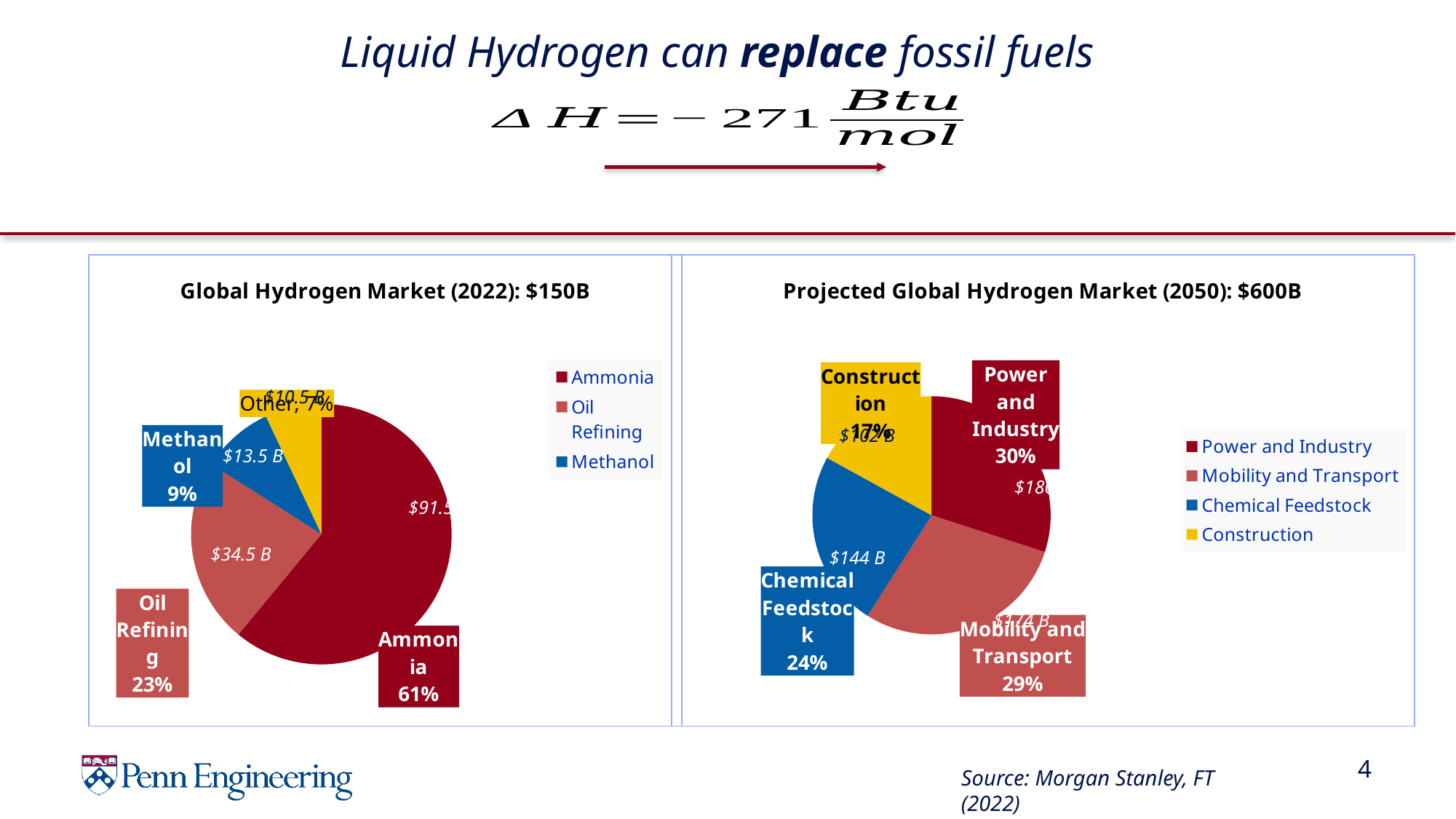
In the Projected Global Hydrogen Market (2050) chart, what is the value for Chemical Feedstock? $144 B In the Projected Global Hydrogen Market (2050) chart, what share does Construction have? 17% In the Projected Global Hydrogen Market (2050) chart, what share does Chemical Feedstock have? 24% In the Global Hydrogen Market (2022) chart, what is the value for Methanol? $13.5 B In the Global Hydrogen Market (2022) chart, what share does Ammonia have? 61% In the Global Hydrogen Market (2022) chart, which category has the smallest slice? Other What kind of chart is the Global Hydrogen Market (2022) chart? pie chart In the Global Hydrogen Market (2022) chart, what is the value for Oil Refining? $34.5 B In the Global Hydrogen Market (2022) chart, which category has the largest slice? Ammonia In the Projected Global Hydrogen Market (2050) chart, what is the difference in share between Power and Industry and Construction? 13% In the Projected Global Hydrogen Market (2050) chart, how many entries does the legend list? 4